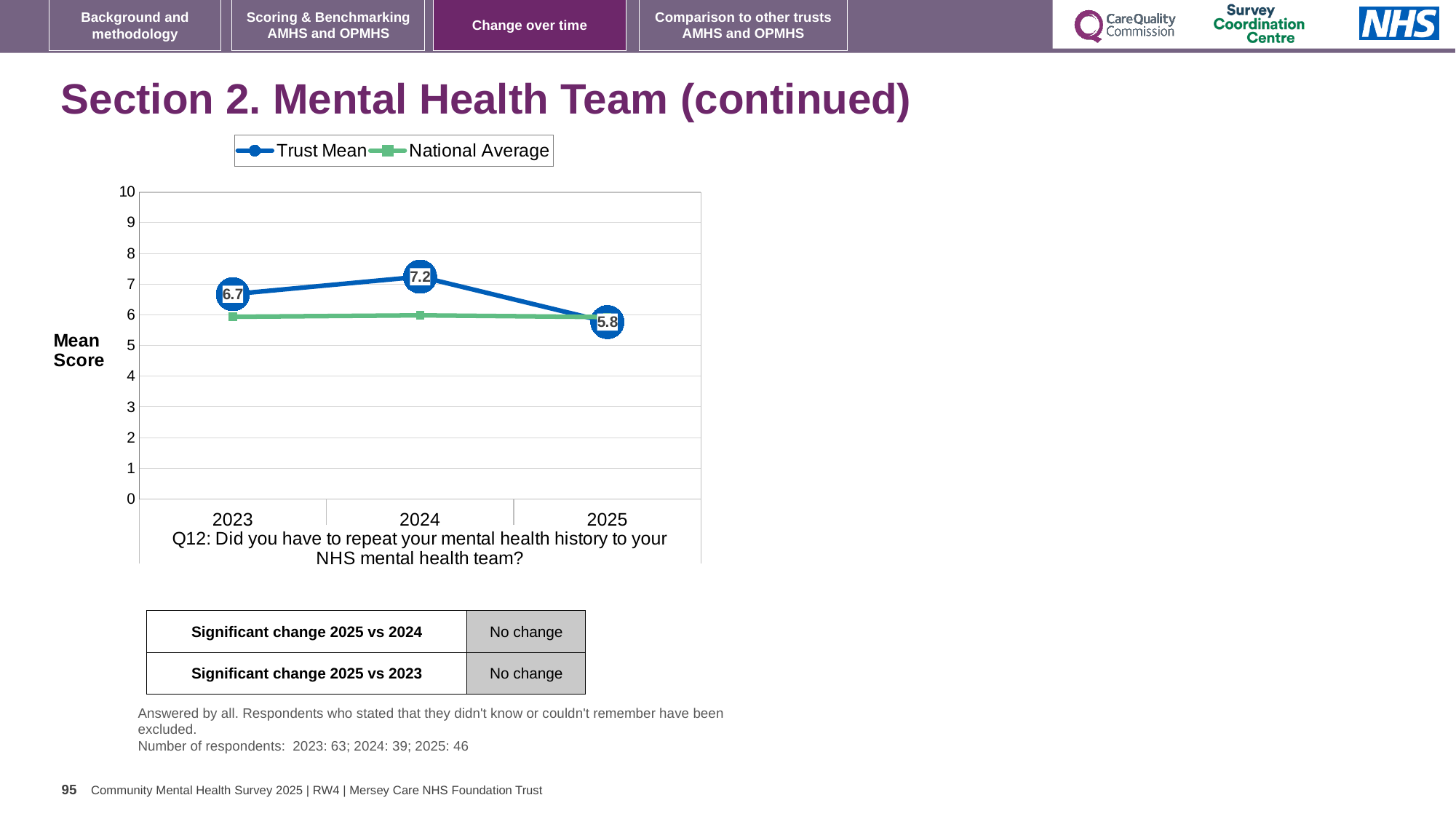
In which year is the Trust Mean lowest? 2025 Is the National Average value for 2023 greater or less than 5? greater What is the Trust Mean value for 2025? 5.8 In 2024, which is larger: the Trust Mean or the National Average? Trust Mean What is the Trust Mean value for 2023? 6.7 How many years are shown on the x axis? 3 What is the difference between the Trust Mean in 2024 and in 2025? 1.4 How many series does the legend list? 2 In which year is the Trust Mean highest? 2024 What kind of chart is shown on the slide? Line chart What is the difference between the Trust Mean in 2024 and in 2023? 0.5 What is the Trust Mean value for 2024? 7.2